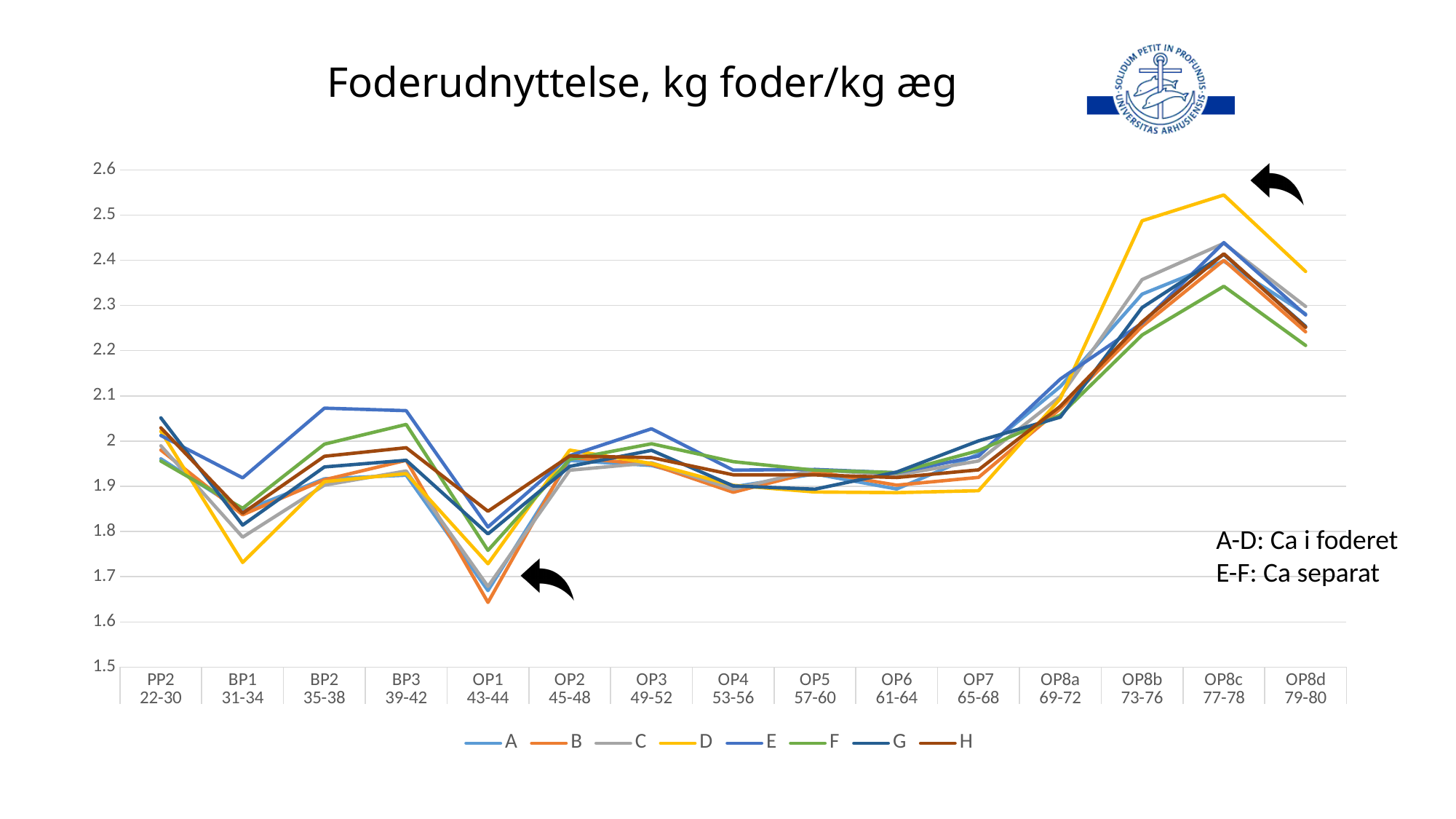
What is the title of the chart? Foderudnyttelse, kg foder/kg æg Which series has the highest value at OP8c 77-78? D How many series does the legend list? 8 Is the value for series F at OP8d 79-80 greater or less than 2.3? less At BP2 35-38, which series has the larger value, E or D? E Which series has the lowest value at OP8c 77-78? F Does series D rise or fall from OP7 65-68 to OP8c 77-78? rise What kind of chart is shown on the slide? line chart Is the value for series D at OP8c 77-78 greater or less than 2.5? greater Is the value for series D at BP1 31-34 greater or less than 1.8? less How many categories are shown along the x axis? 15